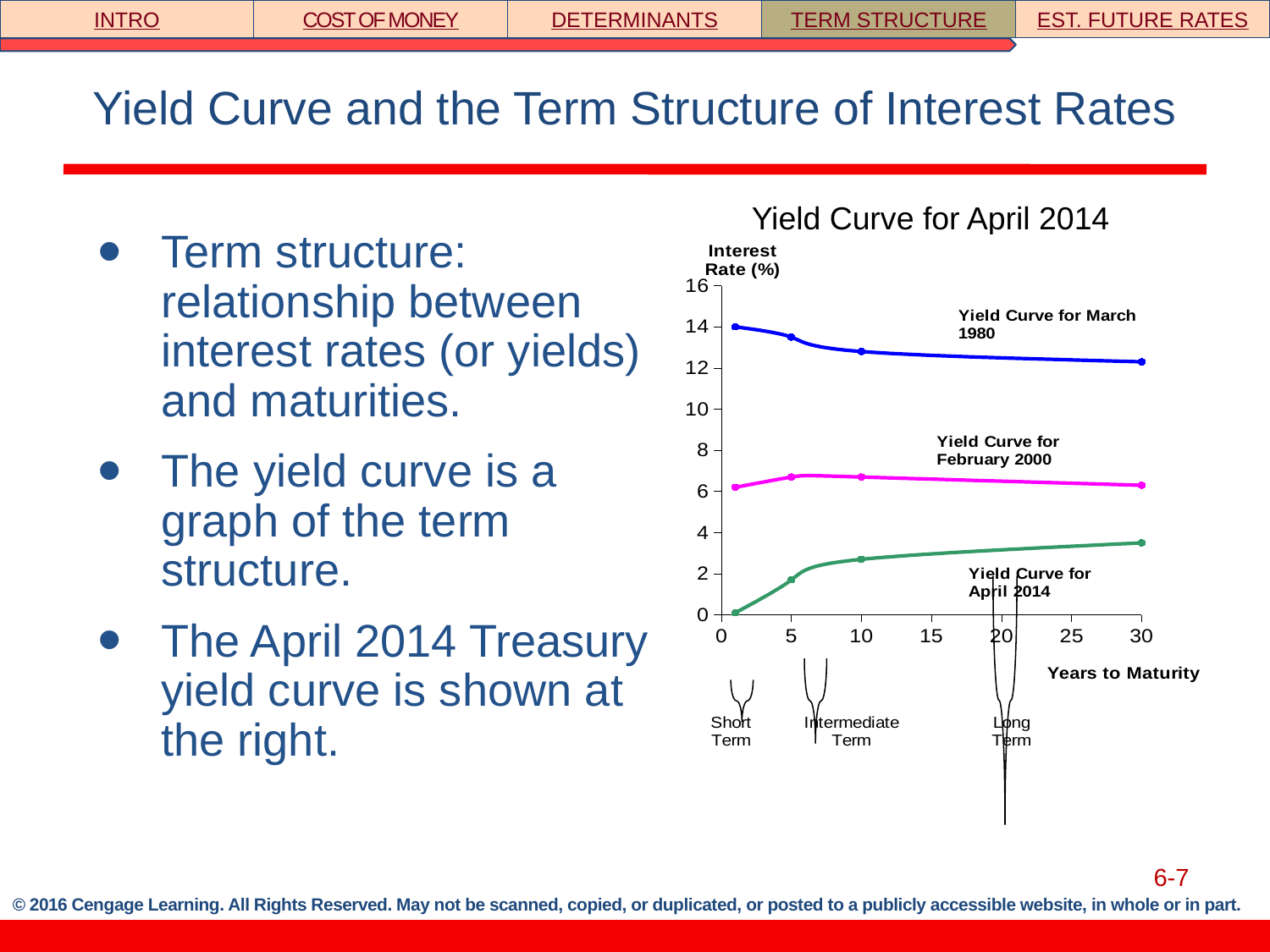
At 30 years to maturity, is the interest rate for the Yield Curve for April 2014 greater or less than 4? less Which yield curve has the lowest interest rates across all maturities? Yield Curve for April 2014 How many yield curves are plotted on the chart? 3 What is the label of the x axis? Years to Maturity At 10 years to maturity, which is larger: the interest rate for the Yield Curve for February 2000 or the Yield Curve for April 2014? Yield Curve for February 2000 How many data points are marked on the Yield Curve for March 1980? 4 Does the Yield Curve for March 1980 rise or fall as years to maturity increase? fall What kind of chart is shown on the slide? line chart At 30 years to maturity, is the interest rate for the Yield Curve for March 1980 greater or less than 10? greater What is the title of the chart? Yield Curve for April 2014 Does the Yield Curve for April 2014 rise or fall as years to maturity increase? rise Which yield curve has the highest interest rates across all maturities? Yield Curve for March 1980